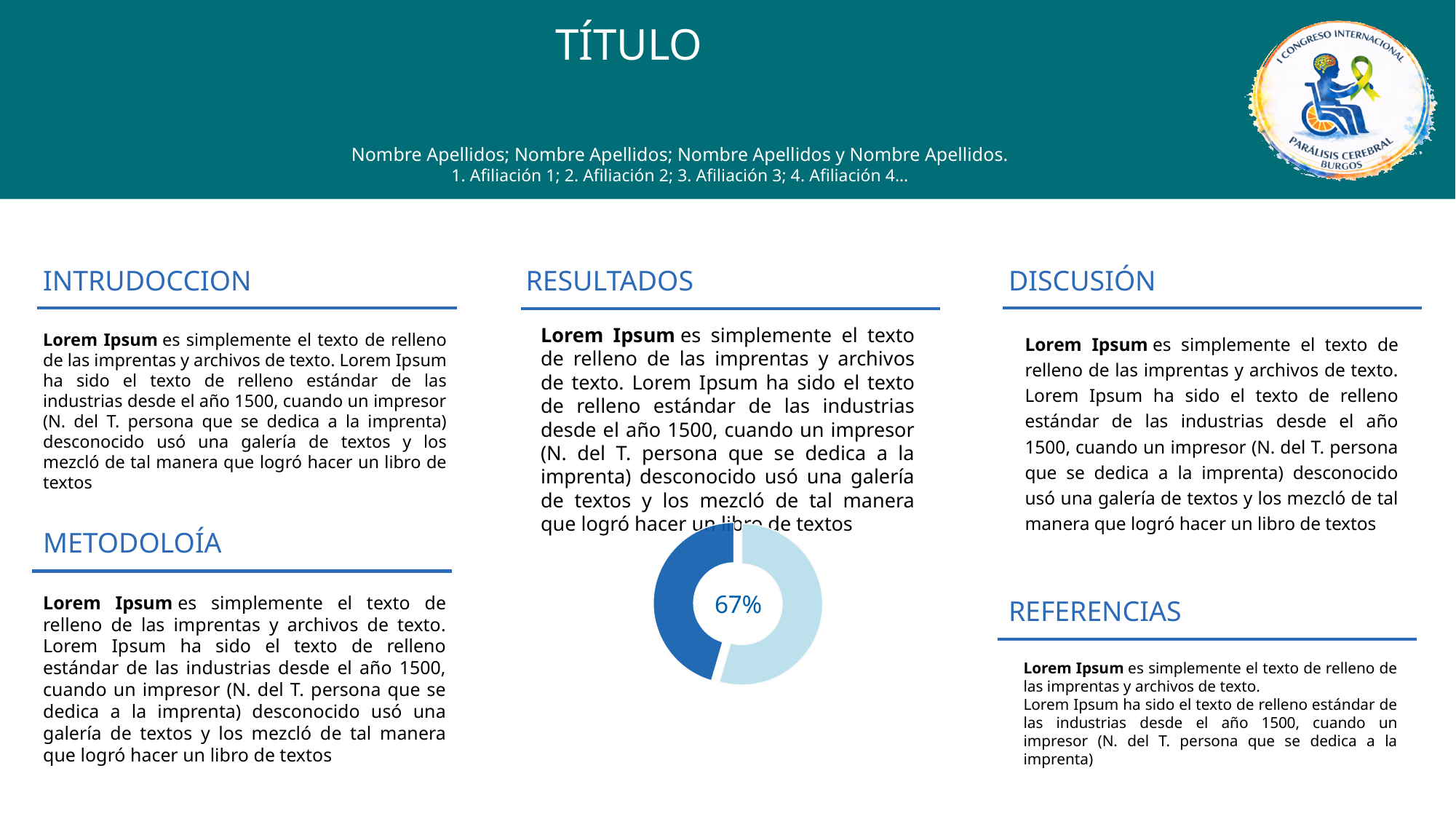
Is the percentage printed in the centre of the doughnut chart greater or less than 50%? greater How many slices does the doughnut chart have? 2 Under which section heading of the poster does the doughnut chart appear? RESULTADOS What kind of chart is shown in the RESULTADOS section of the slide? Doughnut (pie) chart What percentage value is printed in the centre of the doughnut chart? 67% What two colours are used for the slices of the doughnut chart? Dark blue and light blue Does the doughnut chart display a legend? No